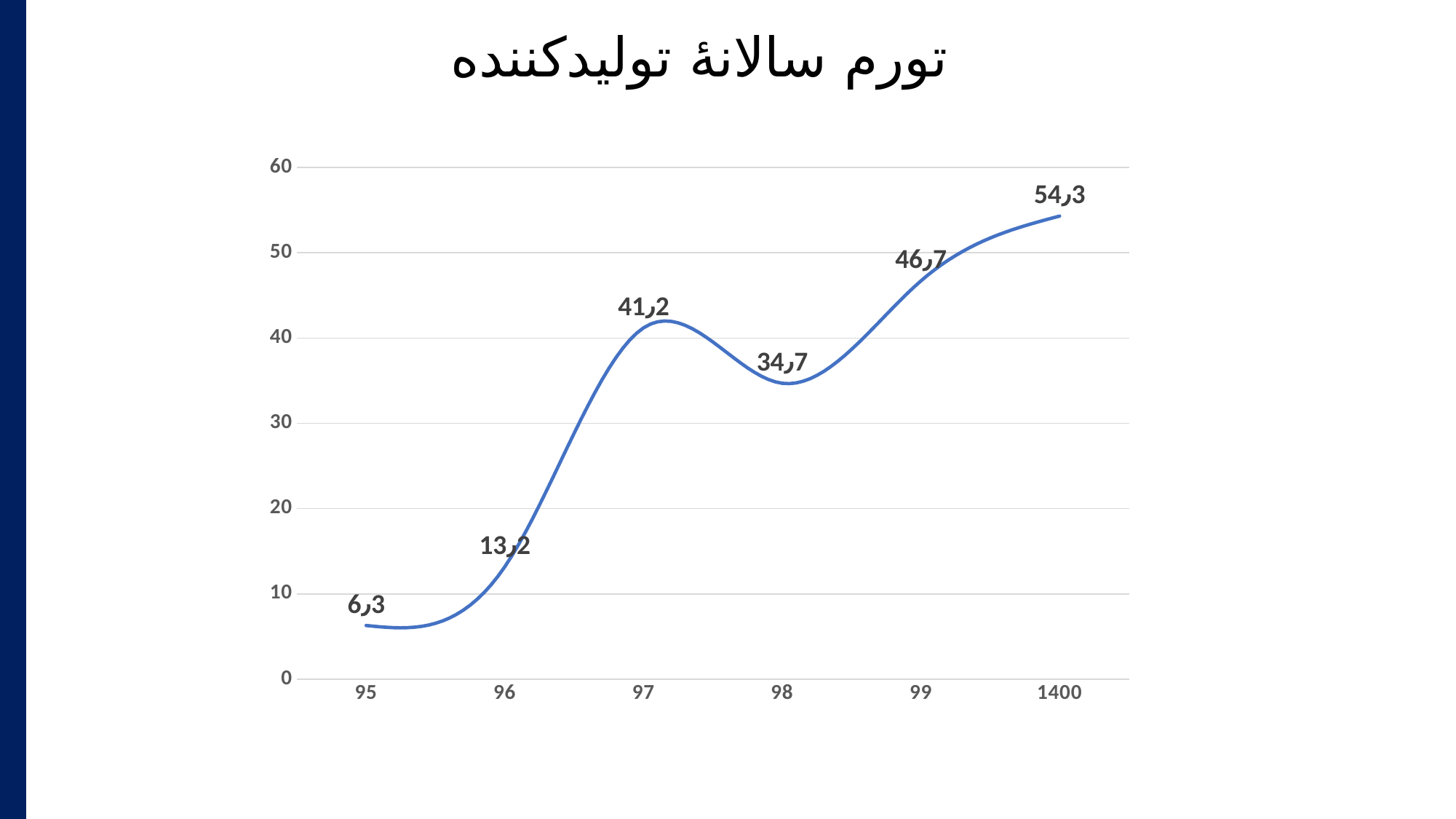
Is the value for 99 greater or less than 40? greater What is the value for 1400? 54٫3 What is the value for 97? 41٫2 How many years are plotted on the x axis? 6 Which is larger, the value for 97 or the value for 98? 97 What is the value for 95? 6٫3 Which year has the highest value? 1400 What is the difference between the values for 97 and 98? 6٫5 What is the difference between the values for 1400 and 95? 48 Which year has the lowest value? 95 What kind of chart is shown? line chart What is the title of the chart? تورم سالانۀ تولیدکننده